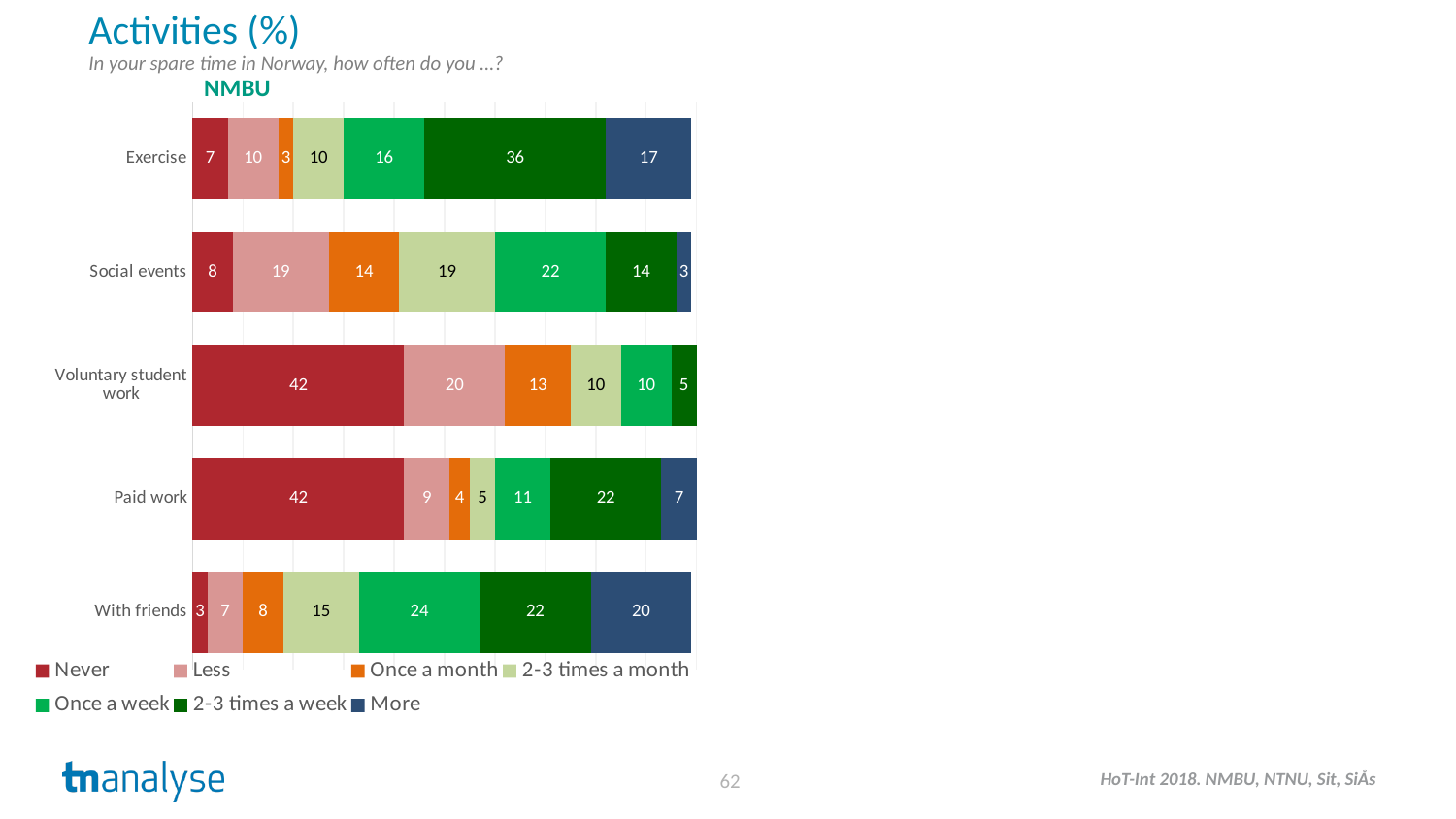
Which activity has the lowest 'Never' value? With friends Which is larger: the 'Once a week' value for Social events or the 'Once a week' value for Paid work? Social events What is the value for 'Less' for Social events? 19 What is the difference between the 'Never' value for Paid work and the 'Never' value for Exercise? 35 What is the value for '2-3 times a week' for Exercise? 36 What kind of chart is shown on the slide? Stacked bar chart Which activity has the highest 'More' value? With friends What is the total of the stacked bar for Paid work? 100 How many series does the legend list? 7 How many activity categories are shown in the chart? 5 What is the value for 'Once a week' for With friends? 24 What is the value for 'Never' for Voluntary student work? 42